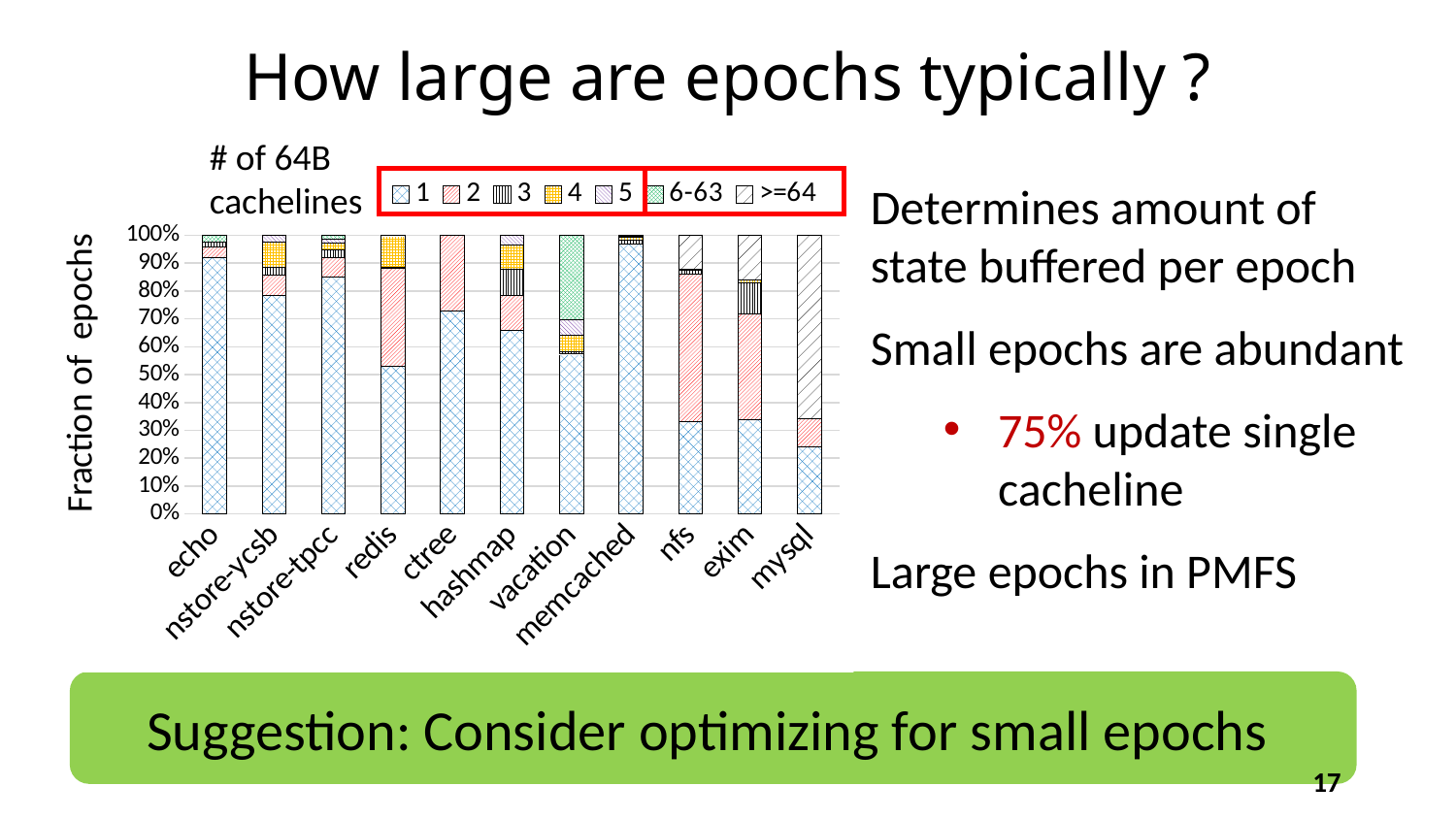
What is the total height of the stacked bar for mysql? 100% Is the fraction of epochs with 1 cacheline for nfs greater or less than 40%? less What is the label of the y axis of the chart? Fraction of epochs Is the fraction of epochs with 1 cacheline for ctree greater or less than 60%? greater Which has a larger fraction of epochs with 1 cacheline, memcached or mysql? memcached Is the fraction of epochs with 1 cacheline for memcached greater or less than 90%? greater What are the legend entries of the chart, in order? 1, 2, 3, 4, 5, 6-63, >=64 What kind of chart is shown on the slide? stacked bar chart How many series does the chart's legend list? 7 Which workload has the smallest fraction of epochs with 1 cacheline? mysql How many categories (workloads) are shown on the x axis of the chart? 11